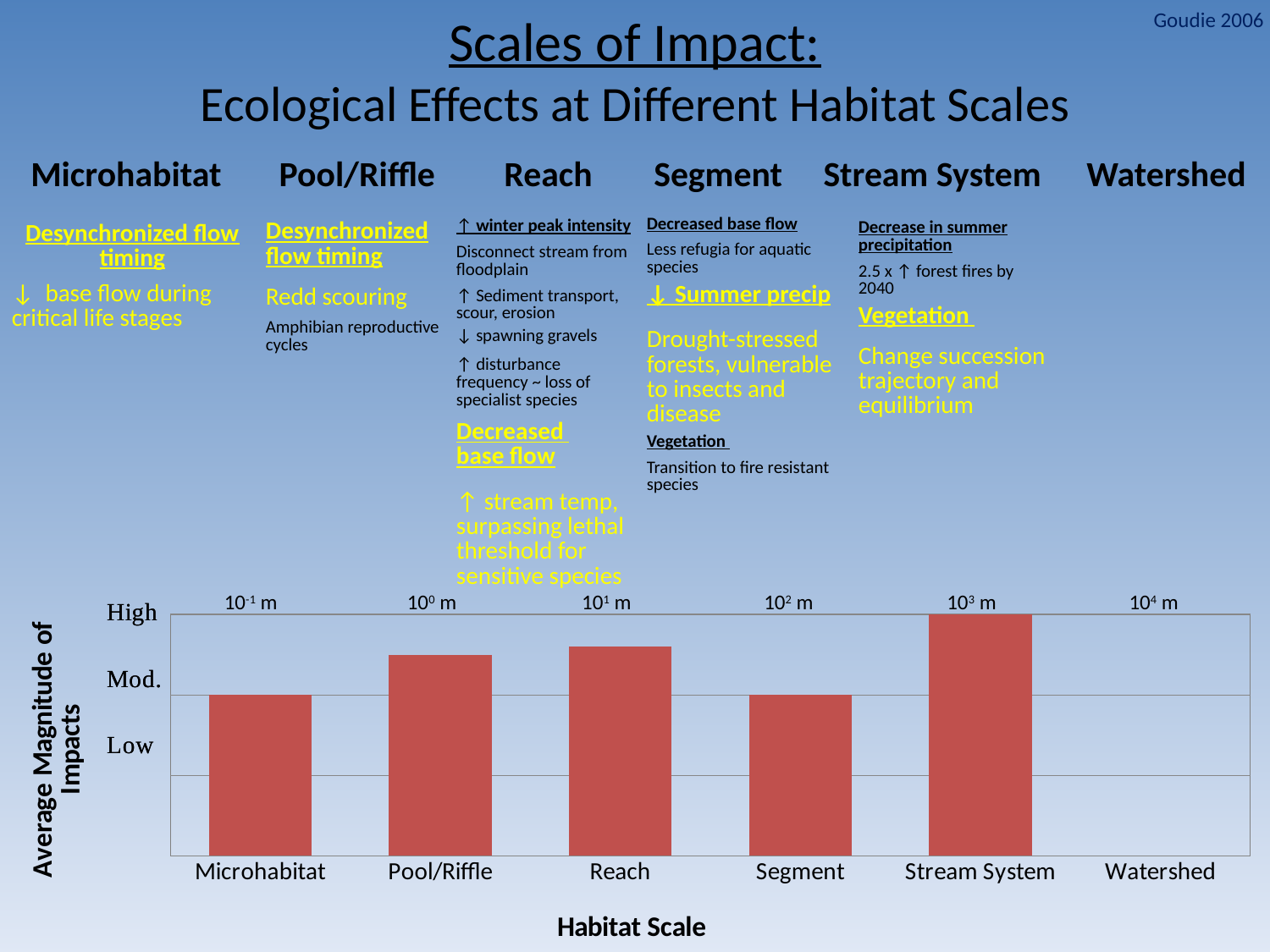
How many habitat scale categories are shown on the x axis of the chart? 6 Which habitat scale category has no visible bar in the chart? Watershed Is the bar for Reach greater or less than the Mod. level on the y axis? greater What is the title of the y axis of the chart? Average Magnitude of Impacts What kind of chart is shown at the bottom of the slide? bar chart What is the title of the x axis of the chart? Habitat Scale Which has a larger average magnitude of impacts, Reach or Segment? Reach Is the bar for Stream System greater or less than the Mod. level on the y axis? greater Which has a larger average magnitude of impacts, Stream System or Reach? Stream System Which habitat scale has the highest bar in the chart? Stream System Which has a larger average magnitude of impacts, Pool/Riffle or Microhabitat? Pool/Riffle